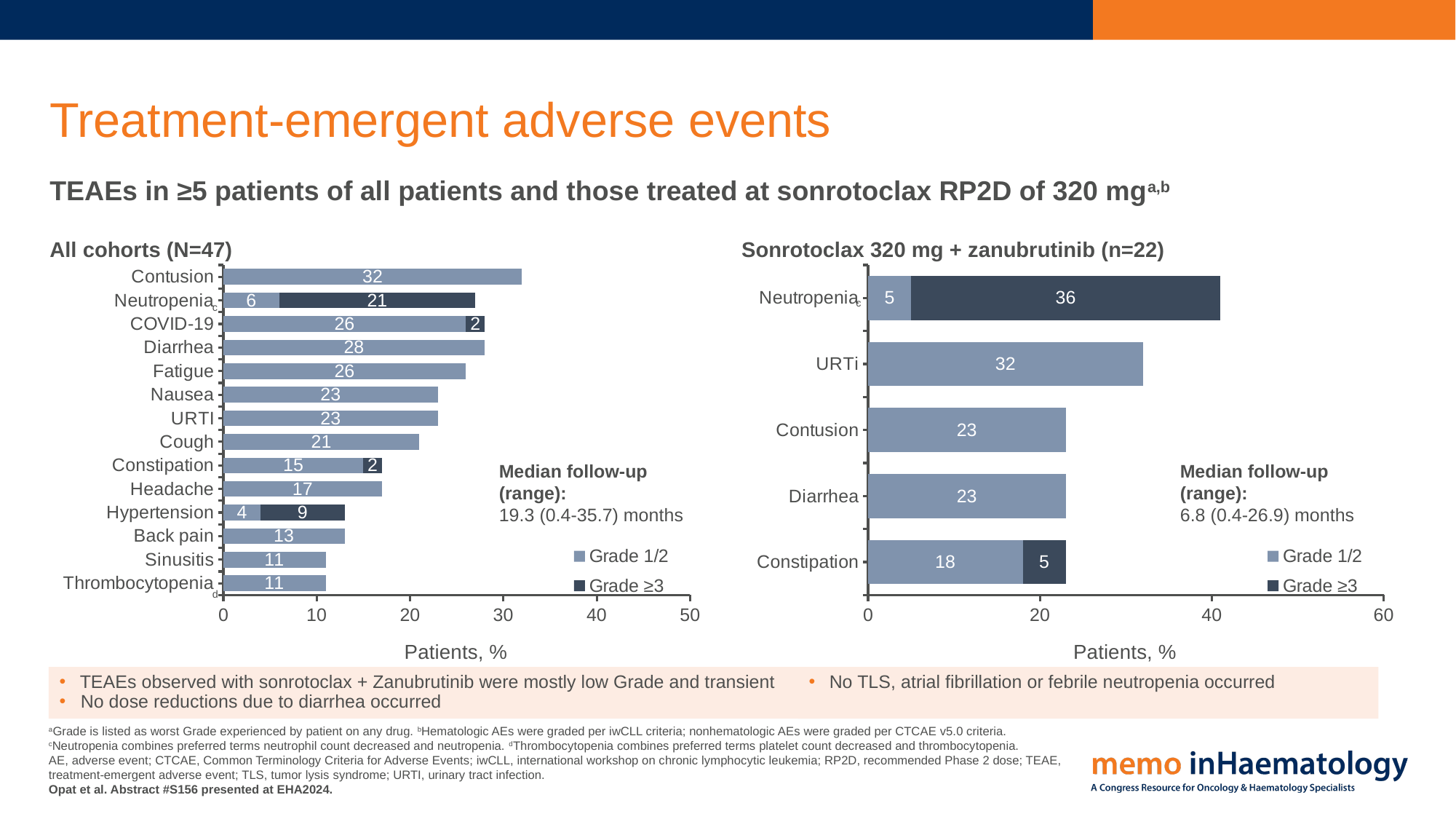
In the 'All cohorts (N=47)' chart, what is the total stacked value for Hypertension? 13 In the 'Sonrotoclax 320 mg + zanubrutinib (n=22)' chart, which is larger: the Grade 1/2 value for URTi or for Contusion? URTi In the 'Sonrotoclax 320 mg + zanubrutinib (n=22)' chart, what is the total stacked value for Constipation? 23 In the 'Sonrotoclax 320 mg + zanubrutinib (n=22)' chart, what is the Grade ≥3 value for Neutropenia? 36 What type of chart is the 'Sonrotoclax 320 mg + zanubrutinib (n=22)' chart? Stacked bar chart In the 'All cohorts (N=47)' chart, what is the Grade ≥3 value for Neutropenia? 21 In the 'Sonrotoclax 320 mg + zanubrutinib (n=22)' chart, how many adverse event categories are shown? 5 In the 'All cohorts (N=47)' chart, how many adverse event categories are listed? 14 In the 'Sonrotoclax 320 mg + zanubrutinib (n=22)' chart, which adverse event has the highest total value? Neutropenia In the 'All cohorts (N=47)' chart, what is the difference between the Grade 1/2 values for Diarrhea and Headache? 11 How many series does the legend of the 'All cohorts (N=47)' chart list? 2 In the 'All cohorts (N=47)' chart, what is the Grade 1/2 value for Contusion? 32